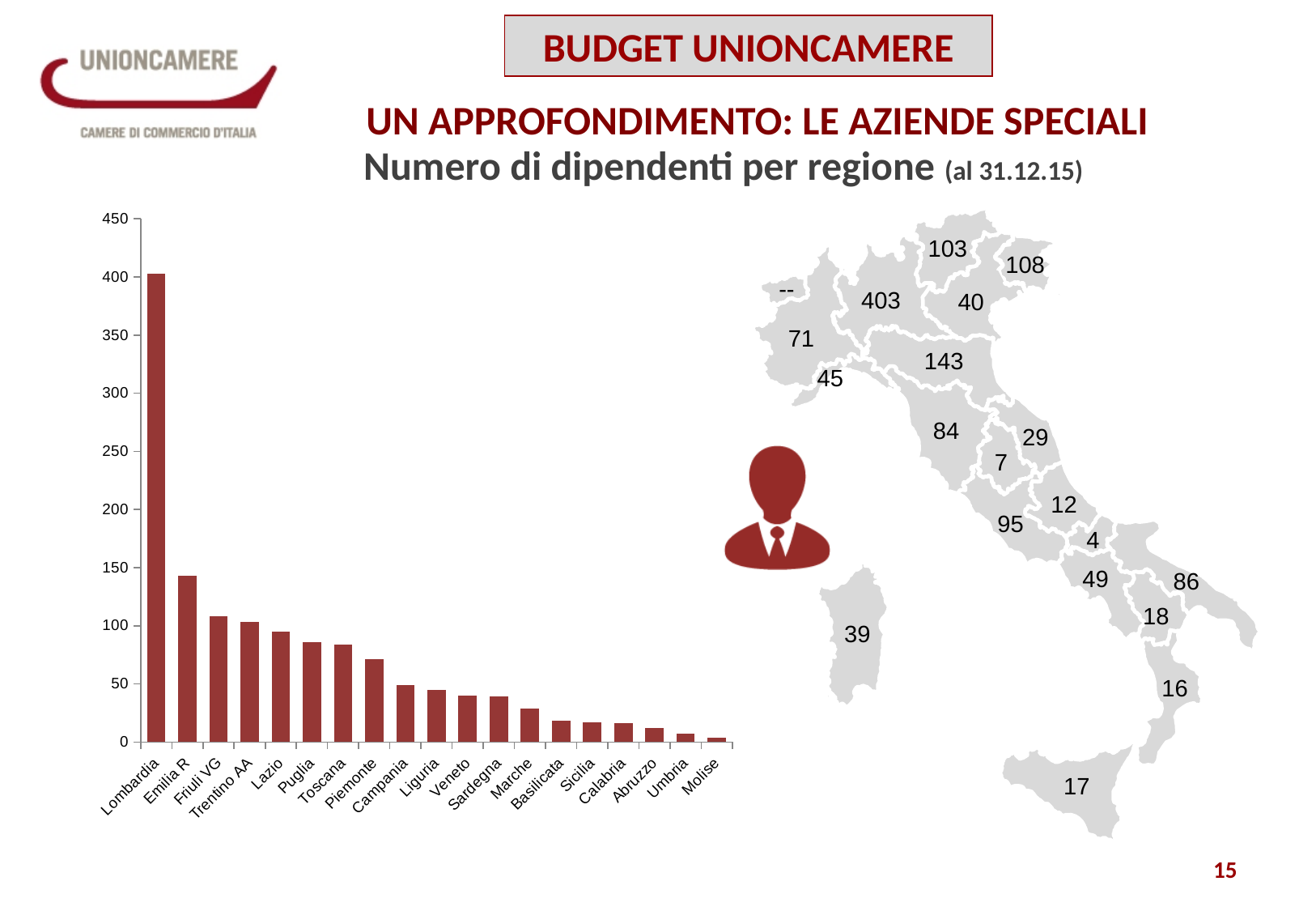
Which region has the lowest bar in the chart? Molise What kind of chart is shown on the left of the slide? bar chart Is the value for Marche greater or less than 50? less Which has the larger value, Piemonte or Campania? Piemonte Which has the larger value, Emilia R or Friuli VG? Emilia R Which region has the highest bar in the chart? Lombardia Is the value for Lombardia greater or less than 350? greater Is the value for Piemonte greater or less than 50? greater Do the bar values rise or fall from left to right along the x axis? fall How many regions are shown on the x axis of the bar chart? 19